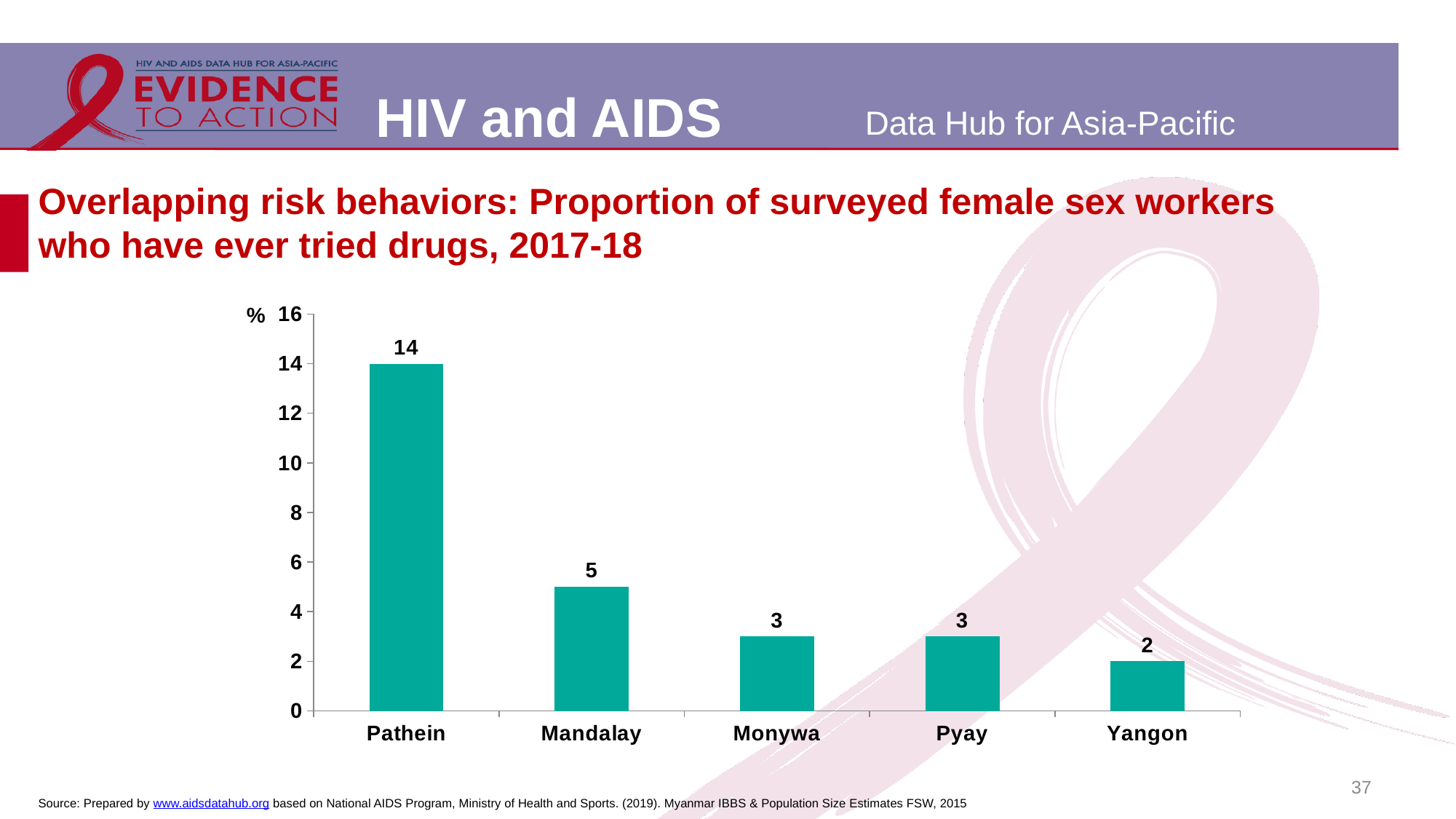
What is the difference between the values for Monywa and Yangon? 1 What is the value for Pathein? 14 Which is larger, the value for Mandalay or the value for Pyay? Mandalay What unit is shown on the y axis of the chart? % Is the value for Pathein greater or less than 10? greater What is the difference between the values for Pathein and Mandalay? 9 What kind of chart is shown on the slide? Bar chart What is the value for Mandalay? 5 How many cities are shown on the chart? 5 Which city has the lowest proportion of surveyed female sex workers who have ever tried drugs? Yangon What is the value for Yangon? 2 Which city has the highest proportion of surveyed female sex workers who have ever tried drugs? Pathein